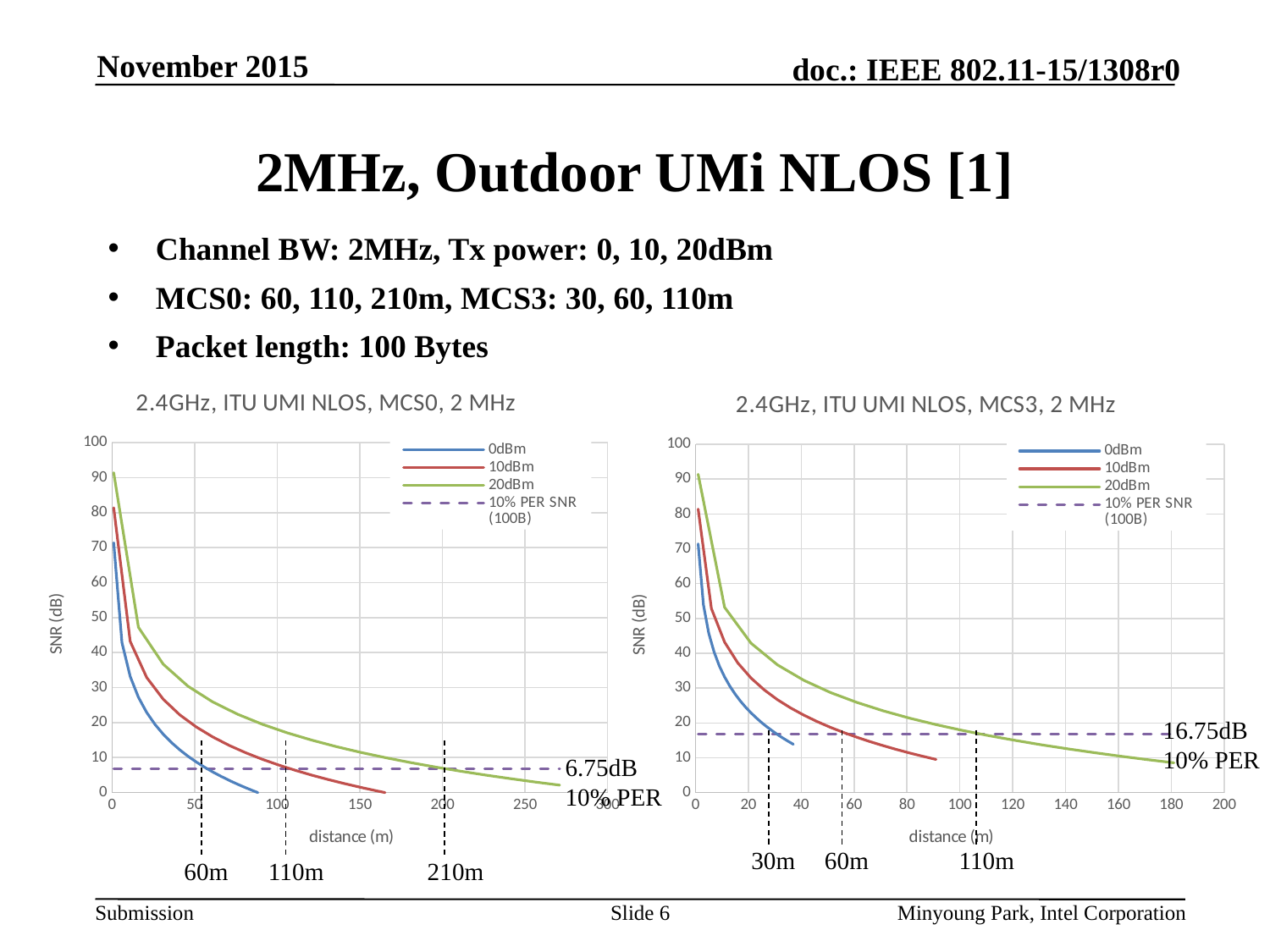
In the left chart (MCS0), at what annotated distance does the 20dBm curve cross the 10% PER SNR line? 210m What is the title of the right chart? 2.4GHz, ITU UMI NLOS, MCS3, 2 MHz How many series does the legend of the right chart (MCS3) list? 4 In the left chart (MCS0), what SNR value is marked for the 10% PER SNR dashed line? 6.75dB In the left chart (MCS0), which series has the highest SNR at a distance of 50 m? 20dBm In the right chart (MCS3), at what annotated distance does the 0dBm curve cross the 10% PER SNR line? 30m In the right chart (MCS3), is the SNR of the 10dBm series at 80 m greater or less than 20? less In the right chart (MCS3), which series reaches the farthest distance along the x axis? 20dBm What kind of chart is the left chart titled '2.4GHz, ITU UMI NLOS, MCS0, 2 MHz'? line chart In the left chart (MCS0), does SNR rise or fall as distance increases? fall In the right chart (MCS3), what SNR value is marked for the 10% PER SNR dashed line? 16.75dB In the left chart (MCS0), is the SNR of the 20dBm series at 50 m greater or less than 20? greater